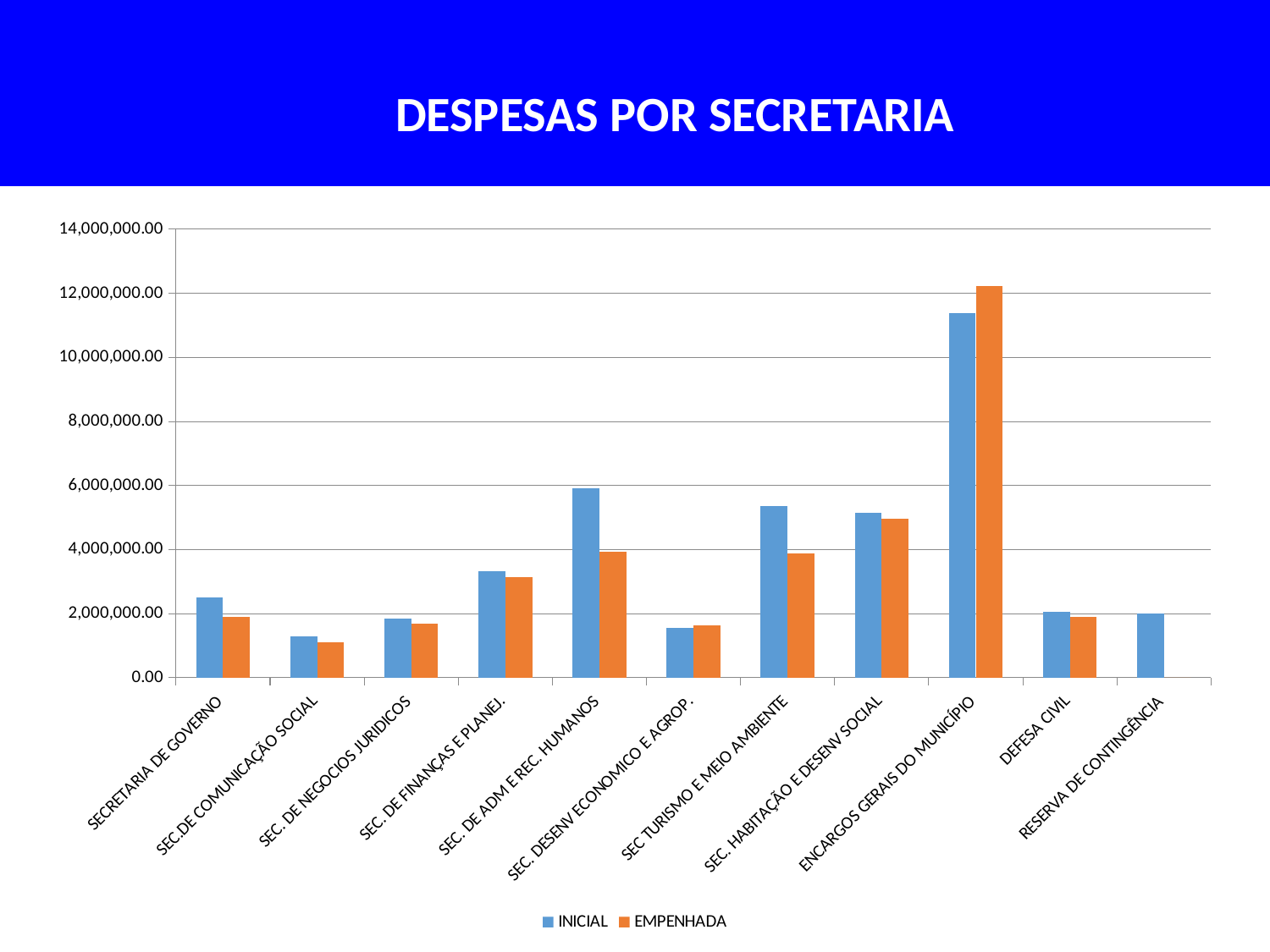
Is the EMPENHADA value for ENCARGOS GERAIS DO MUNICÍPIO greater or less than 10,000,000.00? greater Which category has the lowest INICIAL value? SEC.DE COMUNICAÇÃO SOCIAL Which category has the highest INICIAL value? ENCARGOS GERAIS DO MUNICÍPIO For SEC. DE ADM E REC. HUMANOS, which is larger: INICIAL or EMPENHADA? INICIAL How many series does the legend list? 2 Which category has the highest EMPENHADA value? ENCARGOS GERAIS DO MUNICÍPIO What is the title of the chart? DESPESAS POR SECRETARIA Is the INICIAL value for SEC. DE ADM E REC. HUMANOS greater or less than 4,000,000.00? greater What kind of chart is shown on the slide? Bar chart Is the INICIAL value for SEC. DE FINANÇAS E PLANEJ. greater or less than 4,000,000.00? less How many categories (secretarias) are shown on the x axis? 11 For ENCARGOS GERAIS DO MUNICÍPIO, which is larger: INICIAL or EMPENHADA? EMPENHADA